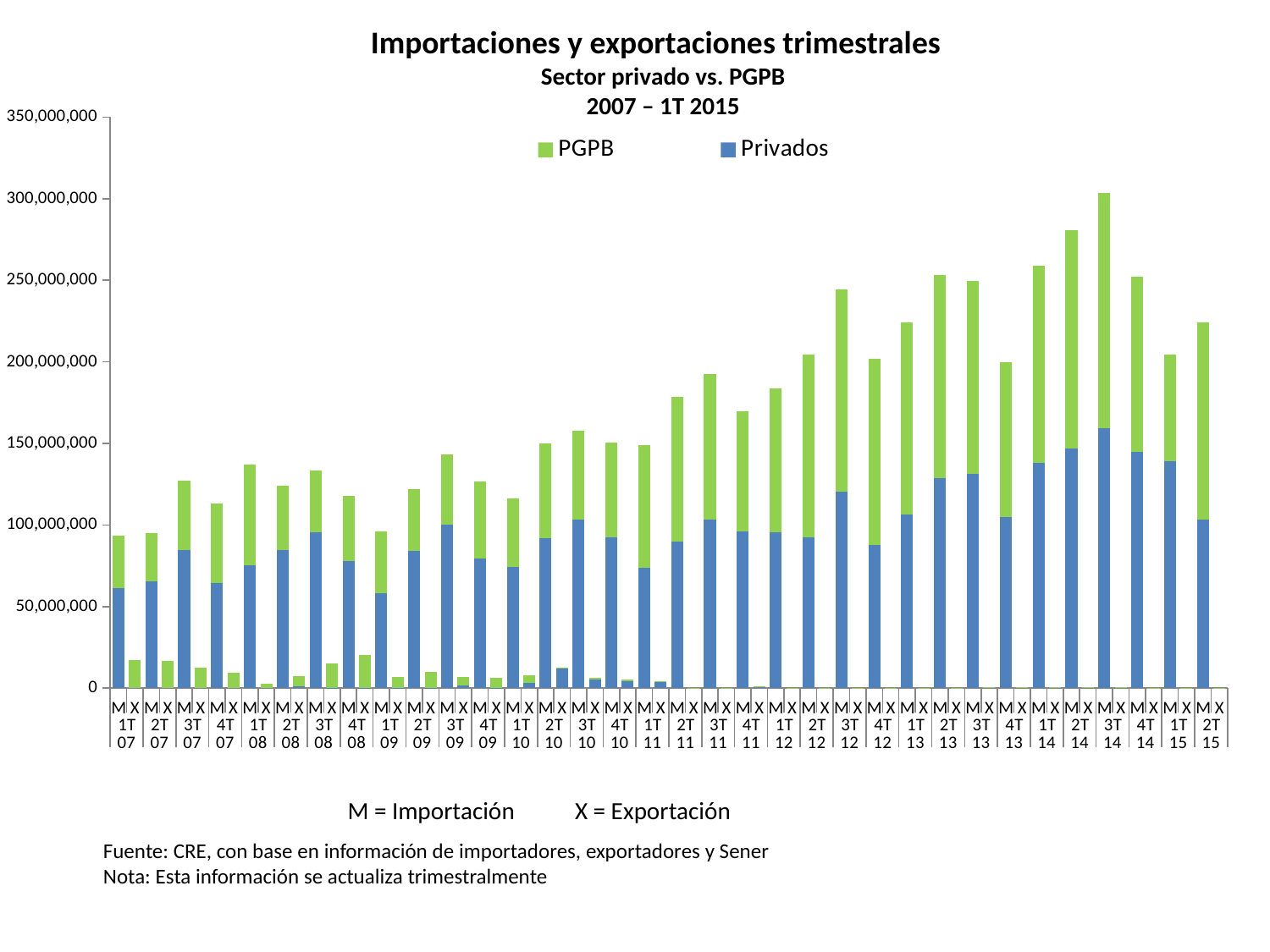
Which bar has the highest total value in the chart? M 3T 14 How many series does the legend list? 2 Do the import (M) bar totals generally rise or fall from 2007 to 2015? Rise Is the total value of the M bar for 1T 07 greater or less than 100,000,000? less Is the total value of the M bar for 1T 09 greater or less than 100,000,000? less Is the total value of the M bar for 3T 14 greater or less than 250,000,000? greater What kind of chart is shown on the slide? Stacked bar chart Which is larger, the total of the M bar for 3T 14 or the M bar for 2T 14? M 3T 14 Which two series are listed in the legend? PGPB and Privados What colour represents the PGPB series? Green Which is larger, the total of the M bar for 1T 07 or the M bar for 2T 15? M 2T 15